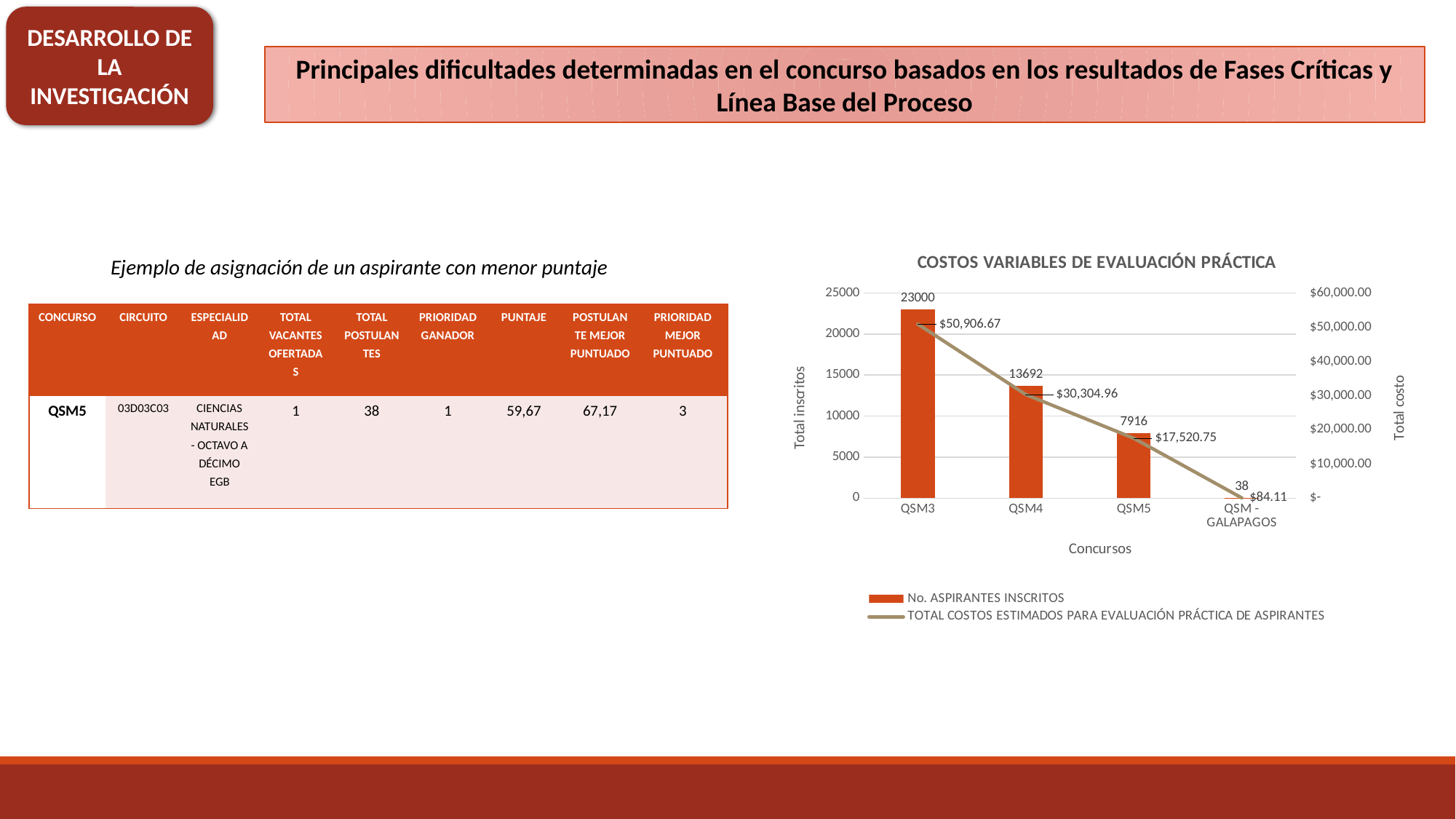
What is the difference in aspirantes inscritos between QSM3 and QSM4? 9308 Do the number of aspirantes inscritos rise or fall from QSM3 to QSM - GALAPAGOS? fall What is the number of aspirantes inscritos for QSM4? 13692 Which concurso has the lowest total estimated cost? QSM - GALAPAGOS What is the title of the chart? COSTOS VARIABLES DE EVALUACIÓN PRÁCTICA What is the number of aspirantes inscritos for QSM3? 23000 Which concurso has the highest number of aspirantes inscritos? QSM3 Which has more aspirantes inscritos, QSM4 or QSM5? QSM4 What is the total estimated cost for evaluación práctica for QSM5? $17,520.75 How many series does the chart legend list? 2 How many concursos are shown on the x axis of the chart? 4 What is the total estimated cost for evaluación práctica for QSM - GALAPAGOS? $84.11